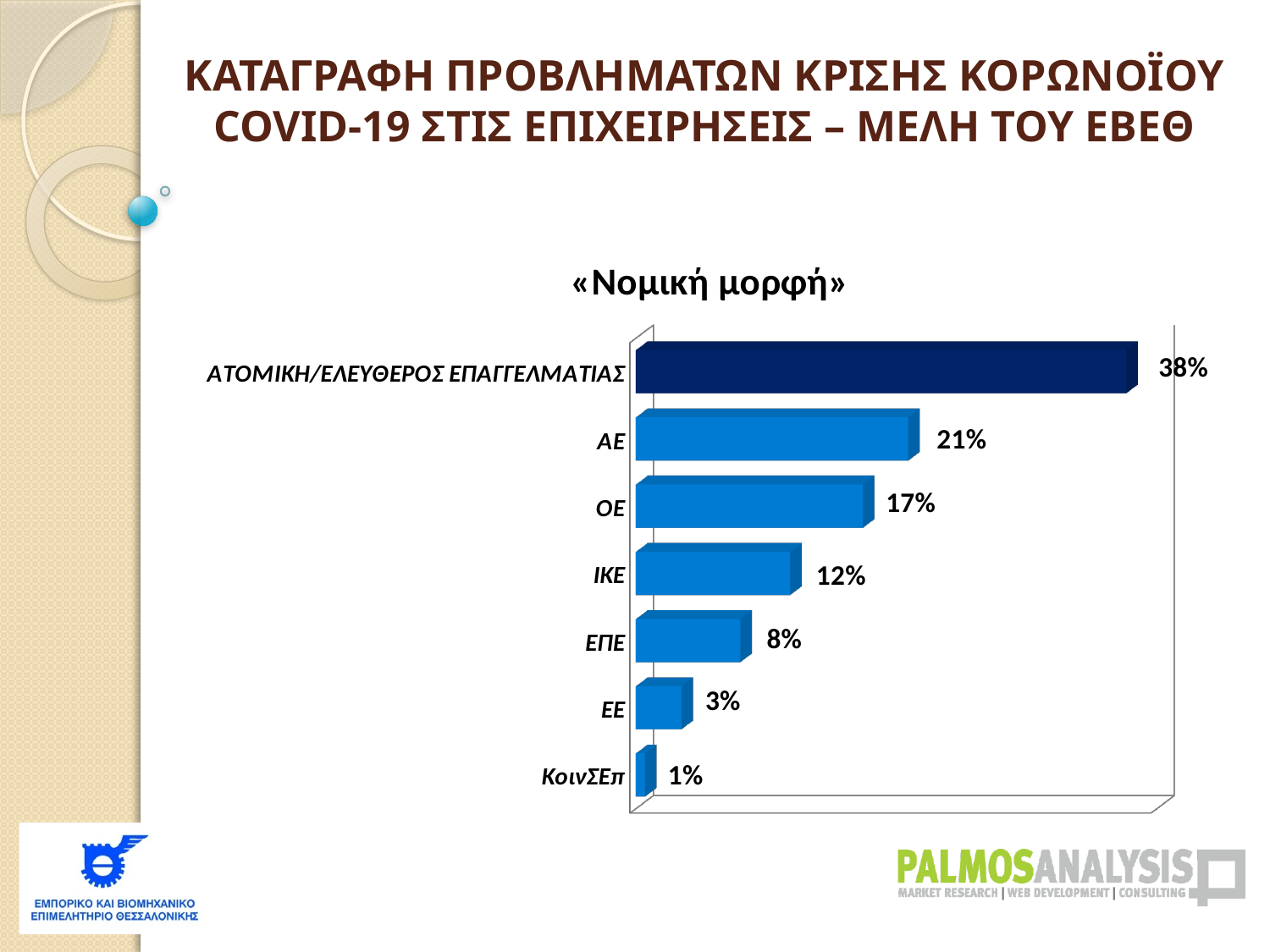
What kind of chart is shown on the slide? Bar chart What is the value for ΟΕ? 17% What is the title of the chart? «Νομική μορφή» What is the difference between the values for ΑΤΟΜΙΚΗ/ΕΛΕΥΘΕΡΟΣ ΕΠΑΓΓΕΛΜΑΤΙΑΣ and ΑΕ? 17% What is the value for ΕΠΕ? 8% What is the value for ΙΚΕ? 12% How many categories are shown in the chart? 7 What is the value for ΑΕ? 21% Which category has the lowest value? ΚοινΣΕπ Which is larger, the value for ΙΚΕ or the value for ΕΠΕ? ΙΚΕ What is the difference between the values for ΟΕ and ΕΕ? 14% Which category has the highest value? ΑΤΟΜΙΚΗ/ΕΛΕΥΘΕΡΟΣ ΕΠΑΓΓΕΛΜΑΤΙΑΣ